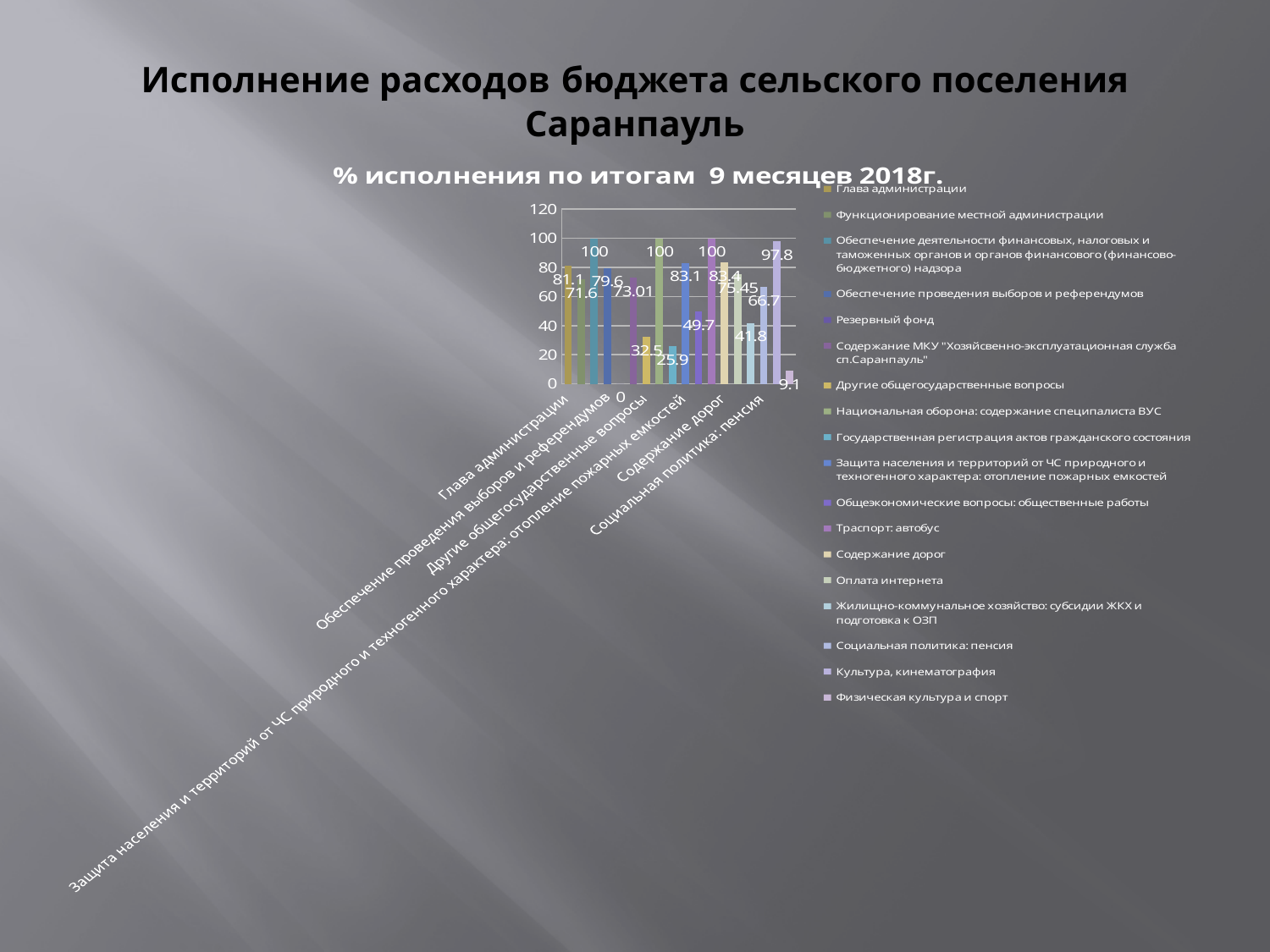
What is the value for Физическая культура и спорт? 9.1 Which series has the lowest value? Резервный фонд What is the value for Культура, кинематография? 97.8 Which is larger, the value for Глава администрации or for Функционирование местной администрации? Глава администрации What is the value for Резервный фонд? 0 What is the value for Глава администрации? 81.1 What is the highest value shown on the vertical axis? 120 How many series does the legend list? 18 What is the value for Социальная политика: пенсия? 66.7 What kind of chart is shown on the slide? bar chart What is the title of the chart? % исполнения по итогам 9 месяцев 2018г. What is the difference between the values for Культура, кинематография and Физическая культура и спорт? 88.7